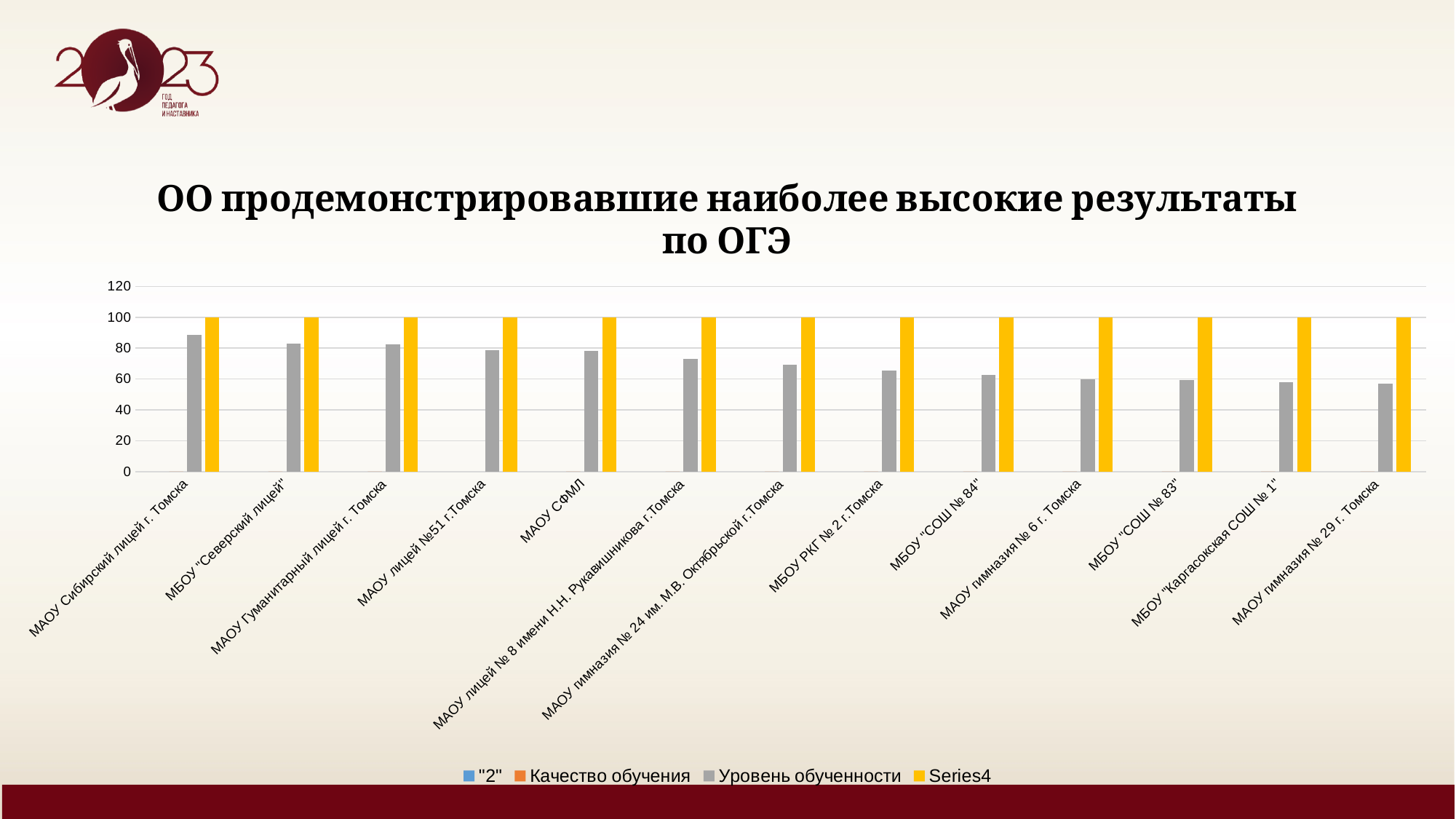
What is the Series4 value for МАОУ СФМЛ? 100 How many educational organisations (categories) are shown on the x axis? 13 What kind of chart is shown on the slide? bar chart Is the Уровень обученности value for МБОУ РКГ № 2 г.Томска greater or less than 80? less Which organisation has the highest Уровень обученности value? МАОУ Сибирский лицей г. Томска How many series does the legend list? 4 Which has the larger Уровень обученности value: МАОУ лицей №51 г.Томска or МБОУ "СОШ № 84"? МАОУ лицей №51 г.Томска What is the title of the chart? ОО продемонстрировавшие наиболее высокие результаты по ОГЭ Is the Уровень обученности value for МАОУ Сибирский лицей г. Томска greater or less than 80? greater Do the Уровень обученности values rise or fall from left to right along the x axis? fall What colour represents Series4 in the legend? yellow Is the Уровень обученности value for МАОУ гимназия № 29 г. Томска greater or less than 80? less